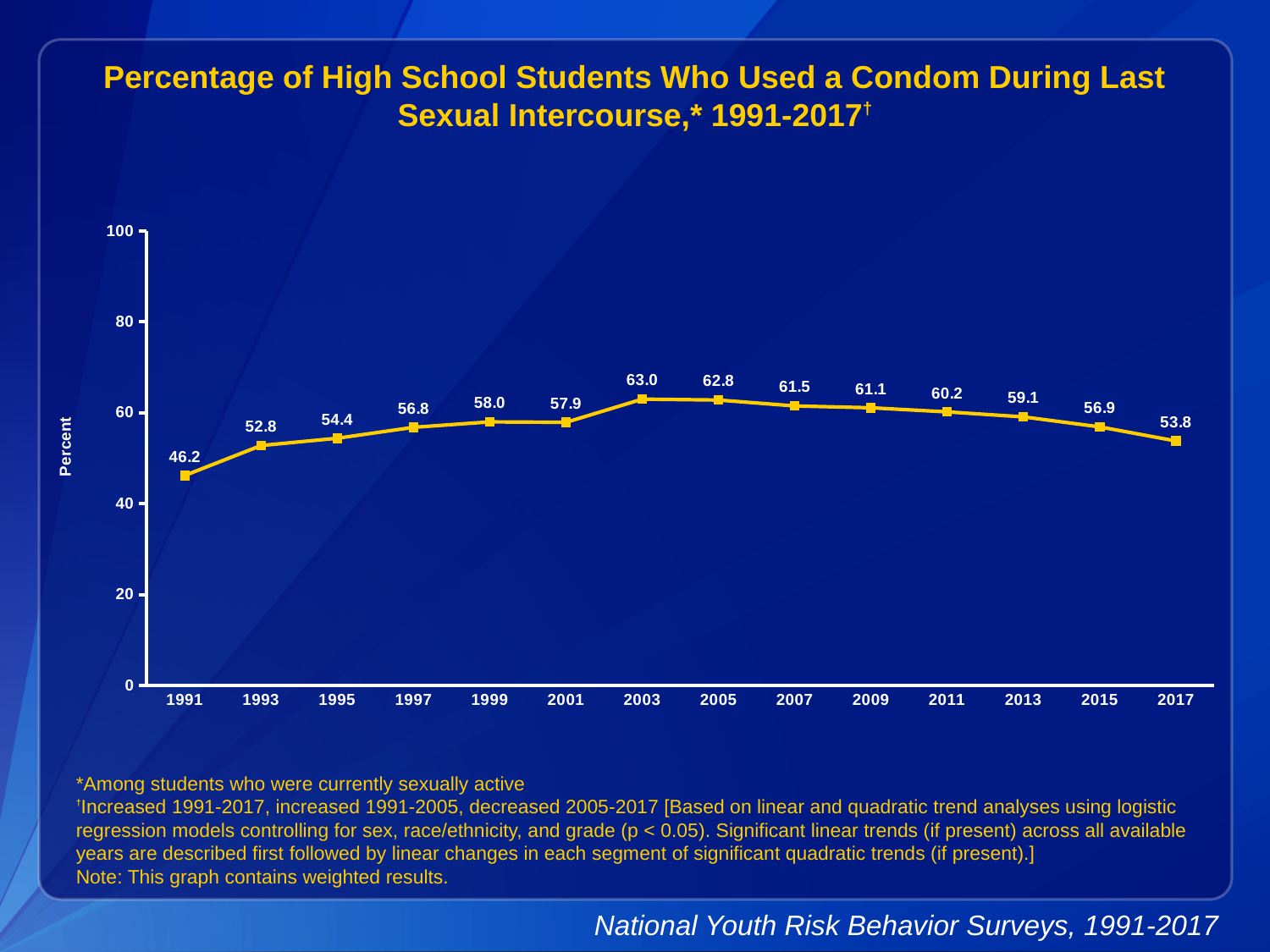
What is the difference between the values for 2003 and 1991? 16.8 What was the percentage of high school students who used a condom during last sexual intercourse in 1991? 46.2 How many years are plotted on the chart? 14 Do the values rise or fall from 2005 to 2017? Fall Which year has a larger value, 1995 or 2013? 2013 What kind of chart is shown on the slide? Line chart Which year has the highest percentage? 2003 Which year has the lowest percentage? 1991 What is the difference between the values for 2005 and 2017? 9.0 What value is shown for 2017? 53.8 What value is shown for 2009? 61.1 Is the value for 2007 greater or less than 80? less